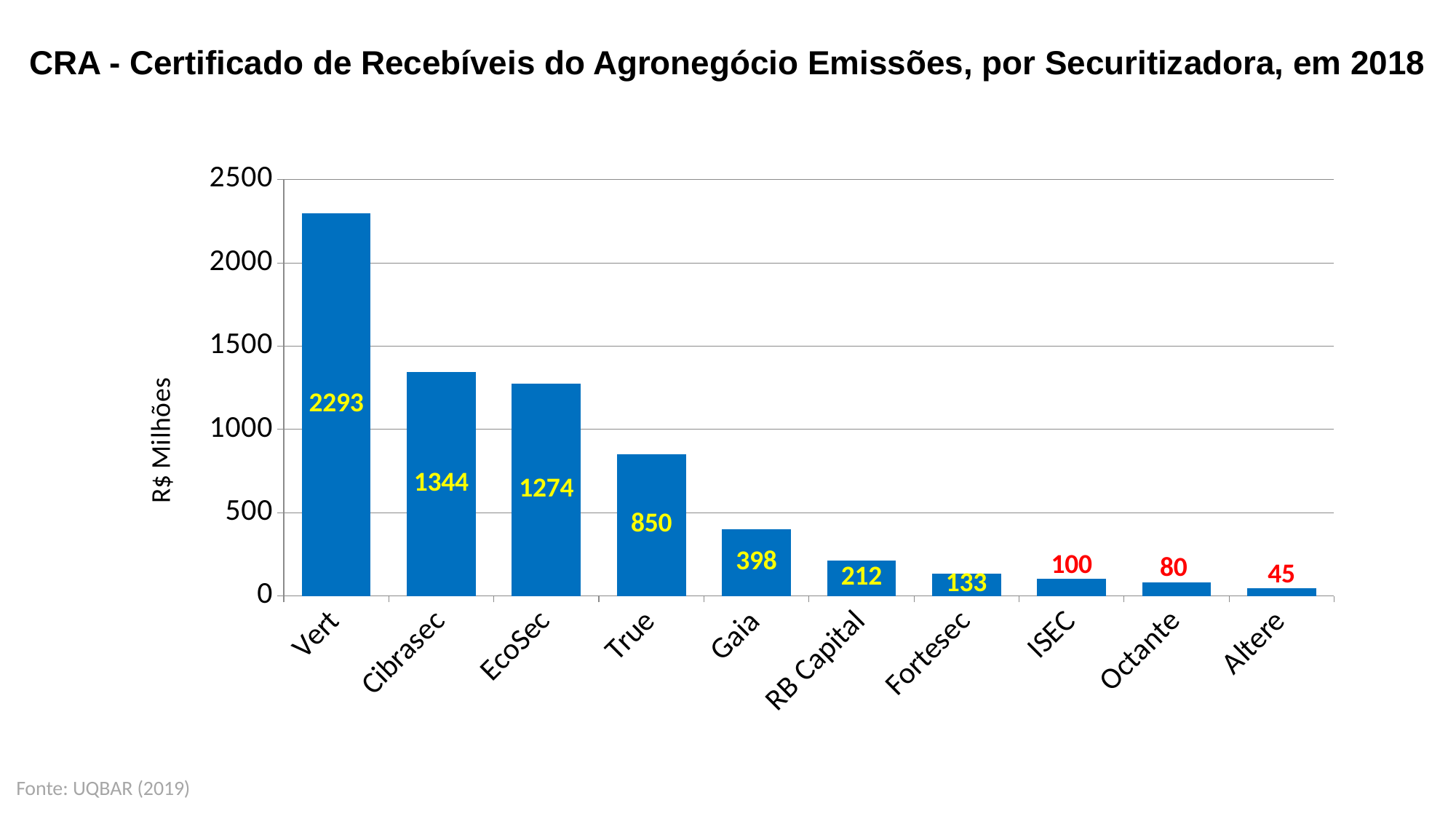
How many securitizadoras are shown on the chart? 10 What is the difference between the values for True and Gaia? 452 What is the value for Vert? 2293 What is the difference between the values for Vert and Cibrasec? 949 What is the label of the vertical axis? R$ Milhões What kind of chart is this? Bar chart Which securitizadora has the highest value? Vert What is the value for Octante? 80 What is the value for Gaia? 398 What is the value for EcoSec? 1274 Which securitizadora has the lowest value? Altere Which is larger, the value for RB Capital or the value for Fortesec? RB Capital